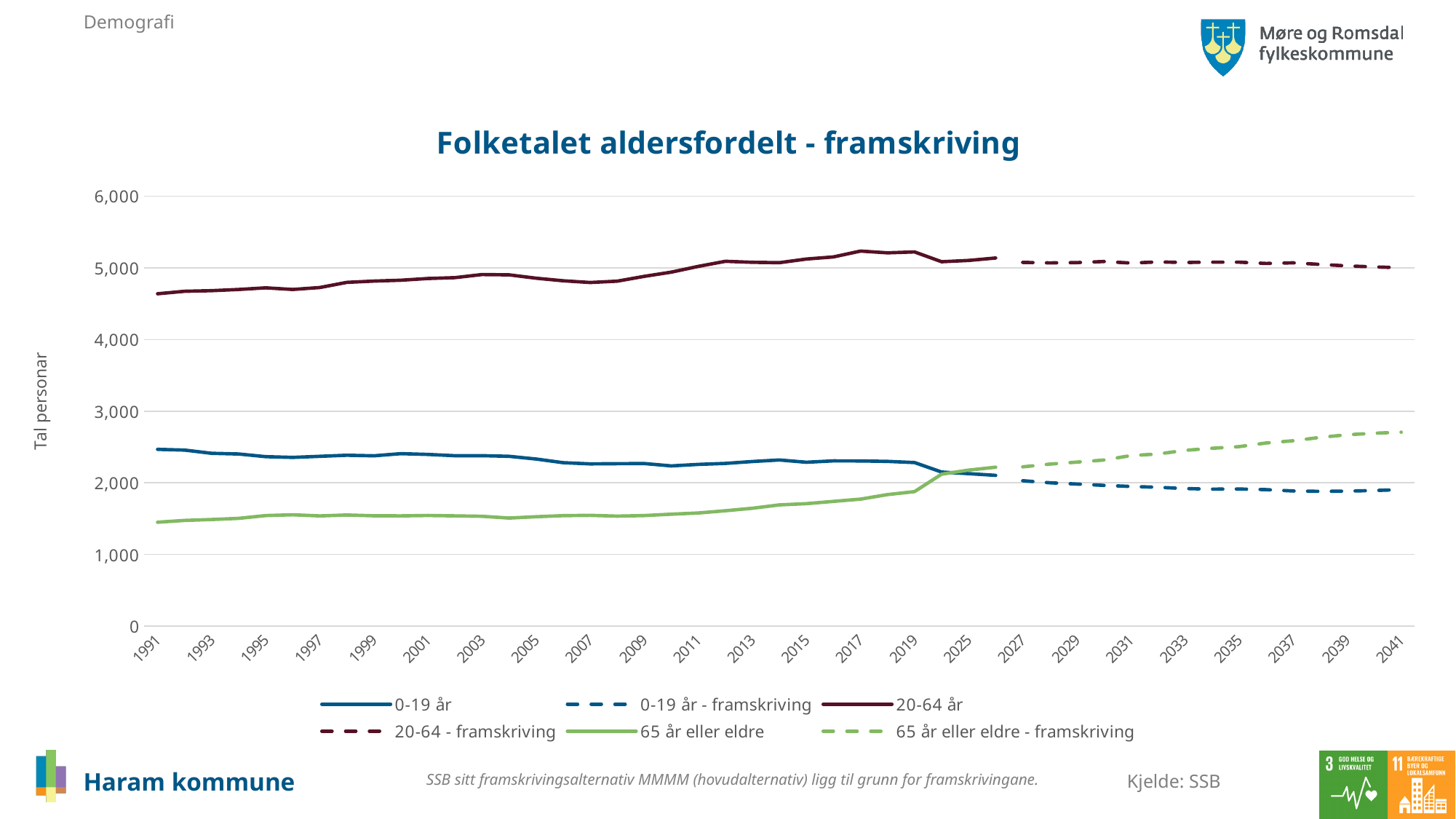
Is the value for 0-19 år - framskriving in 2041 greater or less than 2,000? less What is the title of the chart? Folketalet aldersfordelt - framskriving What is the label on the vertical axis? Tal personar How many series does the legend list? 6 Is the value for 65 år eller eldre - framskriving in 2041 greater or less than 2,000? greater Is the value for 65 år eller eldre in 1991 greater or less than 2,000? less What kind of chart is shown on the slide? line chart Which series has the highest values across the whole chart? 20-64 år Which series has the lowest value in 1991? 65 år eller eldre In 2041, which is larger: 65 år eller eldre - framskriving or 0-19 år - framskriving? 65 år eller eldre - framskriving Does the 65 år eller eldre series rise or fall between 1991 and 2019? rise